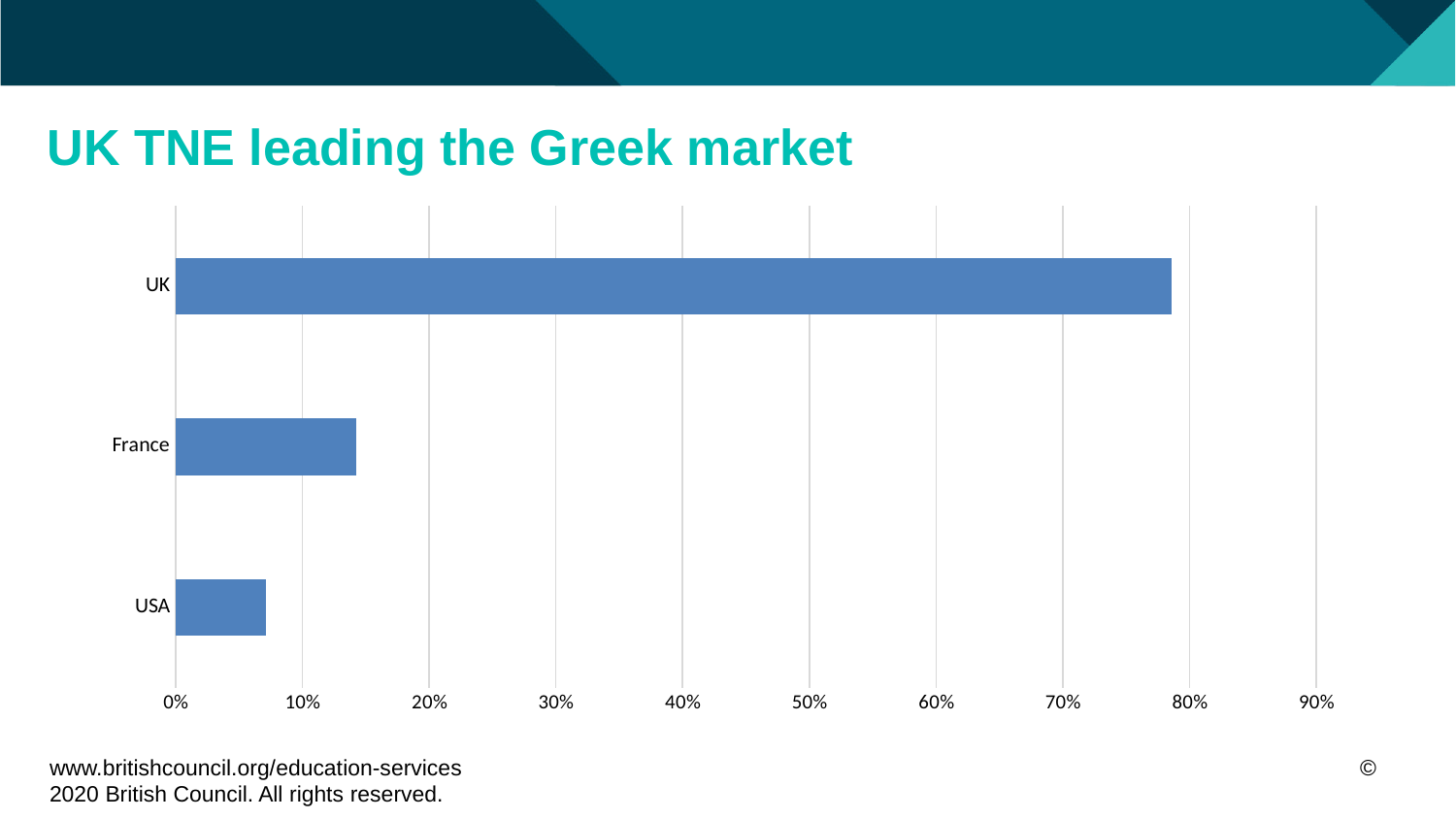
Is the value for UK greater or less than 70%? greater Which is larger, the value for UK or the value for France? UK What is the highest tick label shown on the horizontal axis? 90% What is the title of the slide containing the chart? UK TNE leading the Greek market Is the value for UK greater or less than 80%? less Which is larger, the value for France or the value for USA? France Is the value for USA greater or less than 10%? less What kind of chart is shown on the slide? bar chart How many categories are plotted in the chart? 3 Which category has the highest value? UK Which category has the lowest value? USA